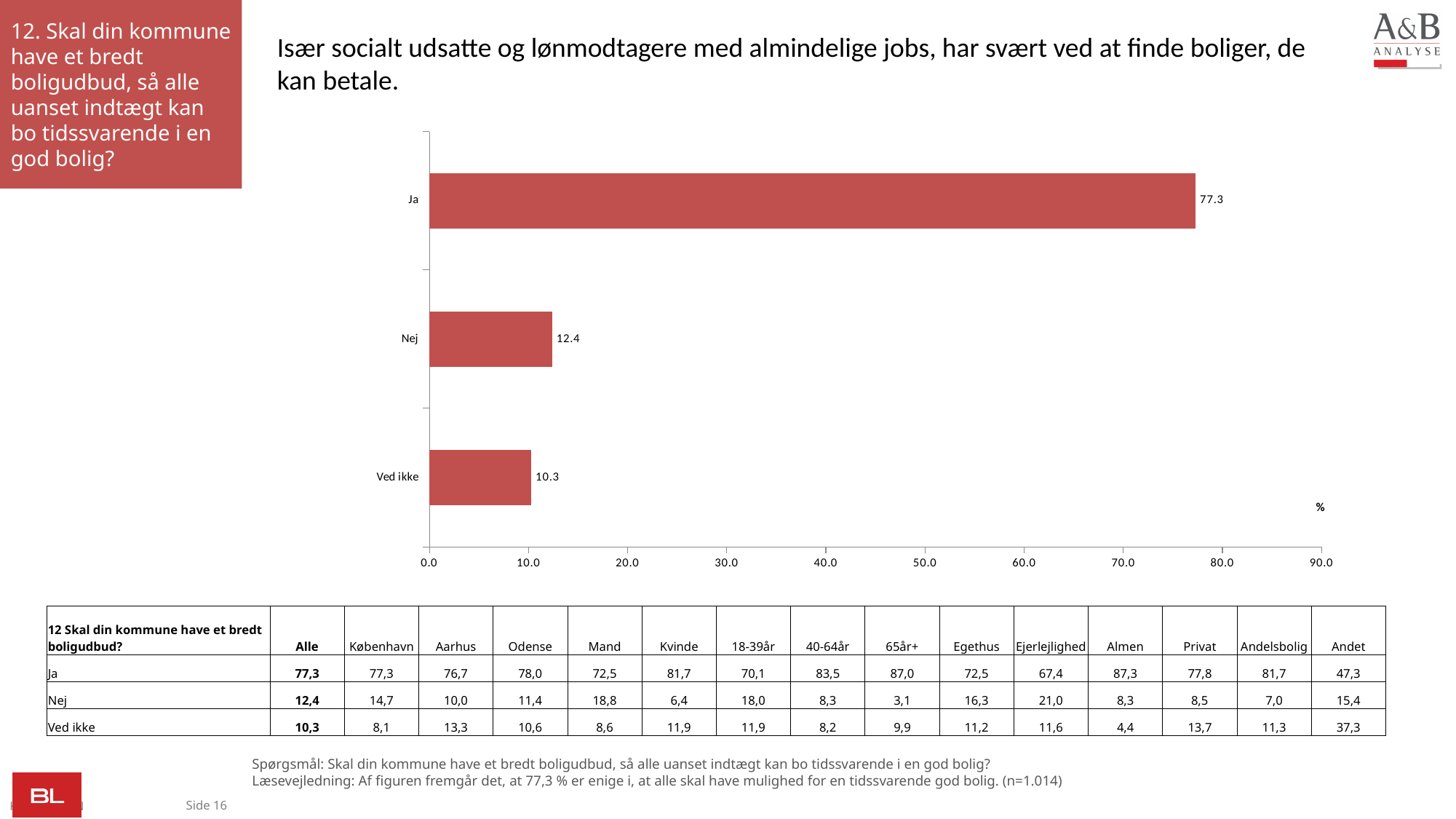
Which category has the lowest value? Ved ikke What is the maximum value shown on the x axis? 90.0 What is the value for Ved ikke? 10.3 Which is larger, the value for Nej or the value for Ved ikke? Nej Which category has the highest value? Ja What is the value for Nej? 12.4 What is the difference between the values for Ja and Nej? 64.9 Is the value for Ja greater or less than 70.0? greater What kind of chart is shown on the slide? bar chart What is the difference between the values for Nej and Ved ikke? 2.1 How many categories are shown in the chart? 3 What is the value for Ja? 77.3